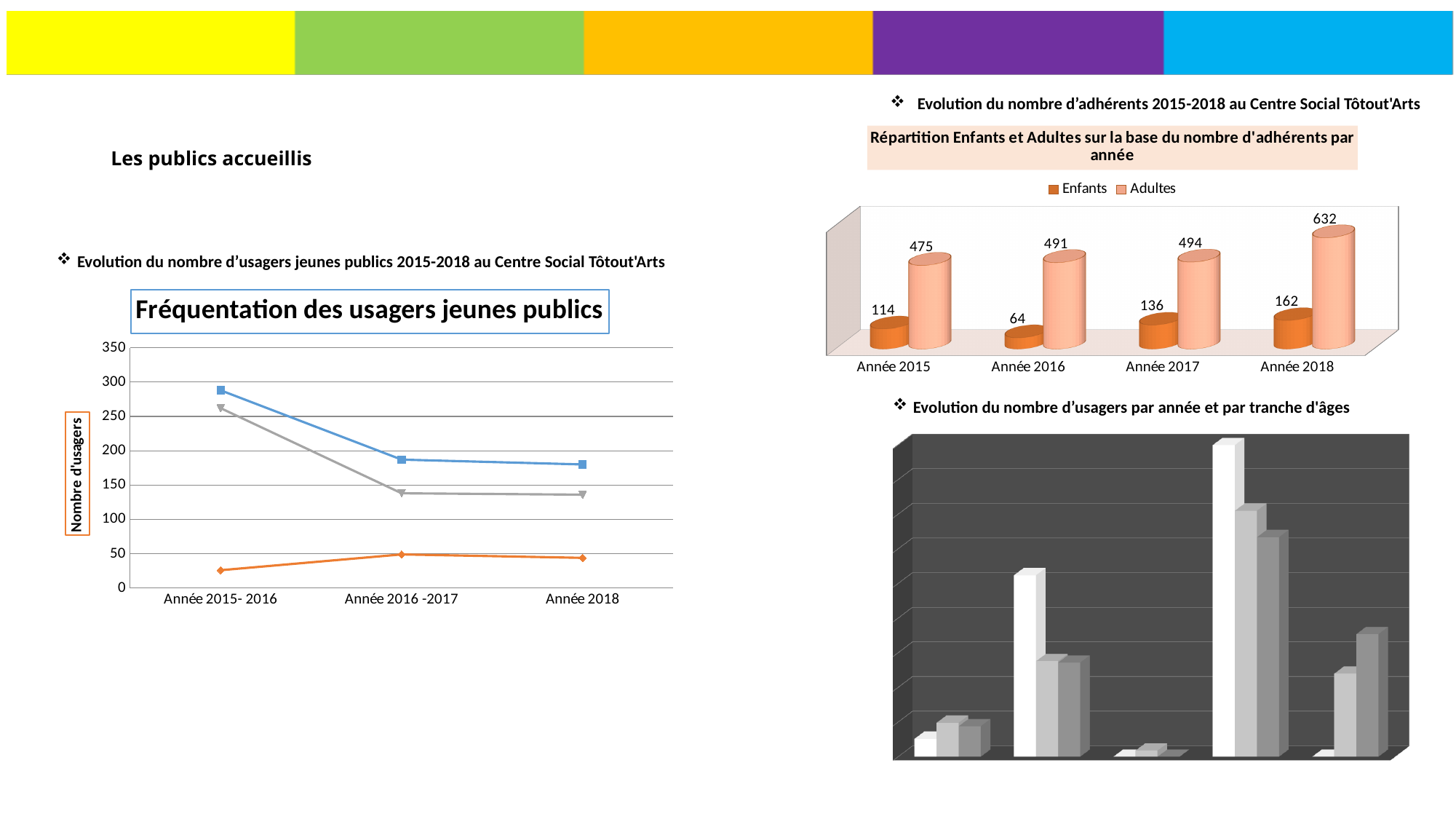
In the chart 'Fréquentation des usagers jeunes publics', how many categories are shown on the x axis? 3 In the chart 'Répartition Enfants et Adultes sur la base du nombre d'adhérents par année', what is the difference between Adultes and Enfants in Année 2017? 358 In the chart 'Fréquentation des usagers jeunes publics', does the blue line rise or fall from Année 2015- 2016 to Année 2018? fall In the chart 'Répartition Enfants et Adultes sur la base du nombre d'adhérents par année', what is the value for Enfants in Année 2016? 64 In the chart 'Répartition Enfants et Adultes sur la base du nombre d'adhérents par année', is the value for Enfants in Année 2015 larger or smaller than the value for Enfants in Année 2017? smaller In the chart 'Répartition Enfants et Adultes sur la base du nombre d'adhérents par année', what is the value for Adultes in Année 2018? 632 In the chart 'Répartition Enfants et Adultes sur la base du nombre d'adhérents par année', how many series does the legend list? 2 In the chart 'Répartition Enfants et Adultes sur la base du nombre d'adhérents par année', which year has the lowest value for Adultes? Année 2015 In the chart 'Répartition Enfants et Adultes sur la base du nombre d'adhérents par année', which year has the highest value for Enfants? Année 2018 In the chart 'Fréquentation des usagers jeunes publics', is the value of the blue line for Année 2015- 2016 greater or less than 250? greater What kind of chart is 'Fréquentation des usagers jeunes publics'? line chart In the chart 'Répartition Enfants et Adultes sur la base du nombre d'adhérents par année', how many years are shown on the x axis? 4